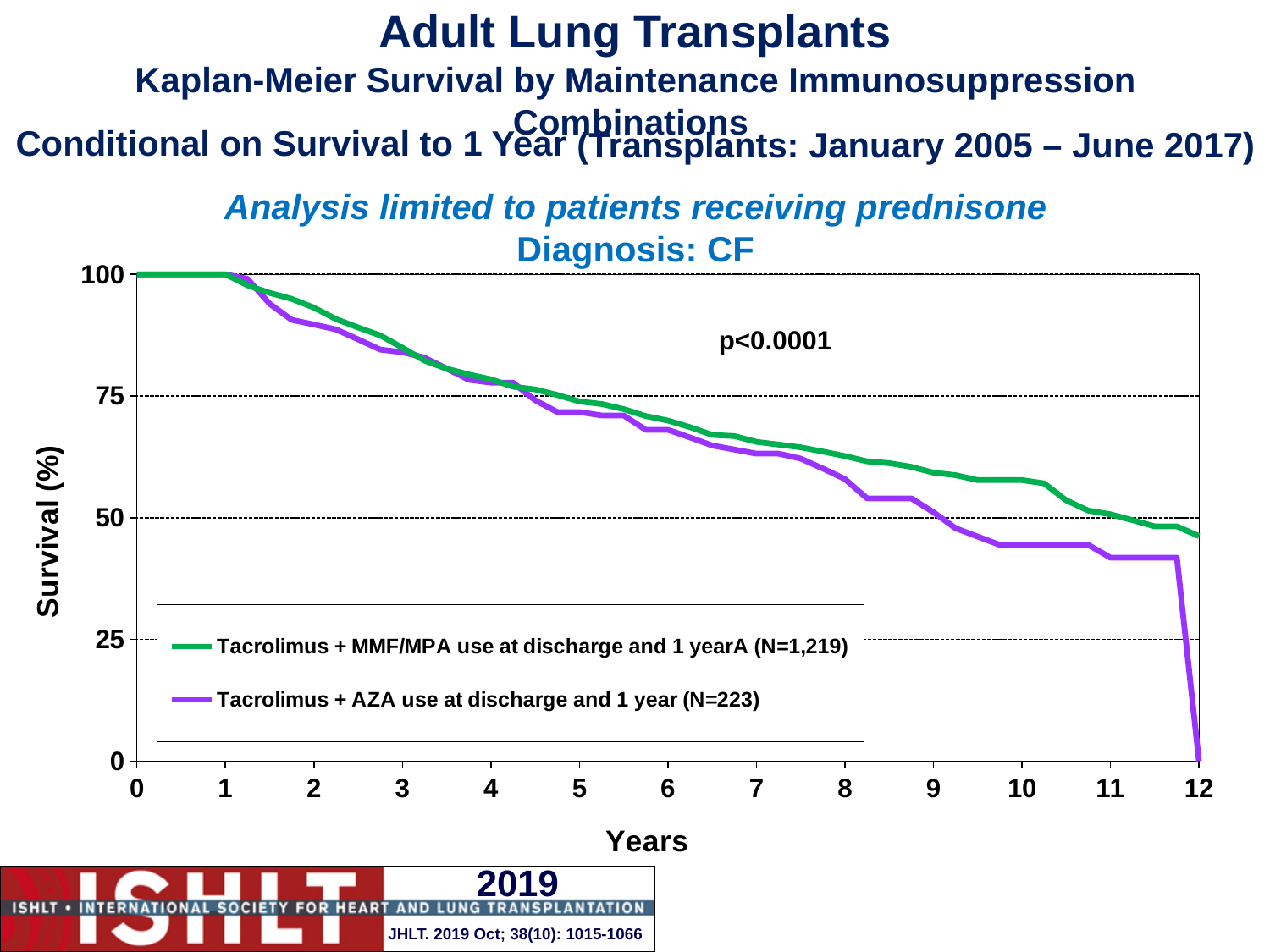
Is the survival value for the Tacrolimus + MMF/MPA group at year 2 greater or less than 75? greater Do the survival curves rise or fall as years increase? Fall At year 10, which group has the higher survival: Tacrolimus + MMF/MPA or Tacrolimus + AZA? Tacrolimus + MMF/MPA What p-value is printed on the chart? p<0.0001 What is the label of the y axis? Survival (%) How many series does the legend list? 2 Is the survival value for the Tacrolimus + AZA group at year 8 greater or less than 50? greater What kind of chart is shown on the slide? Line chart Is the survival value for the Tacrolimus + MMF/MPA group at year 6 greater or less than 75? less What is the N for the Tacrolimus + AZA use at discharge and 1 year group in the legend? 223